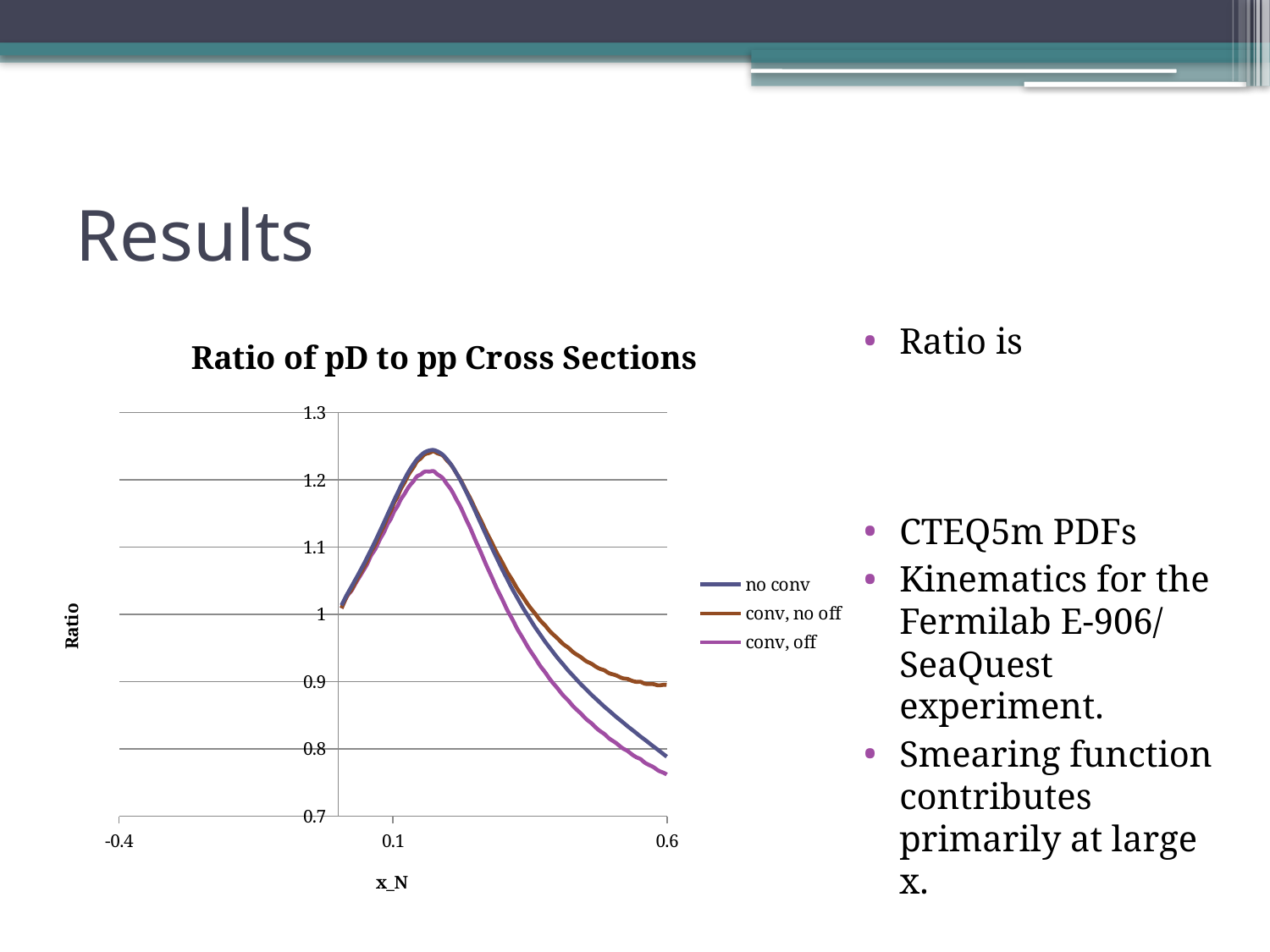
At x_N = 0.6, which series has the lowest value? conv, off Is the peak value of the 'conv, no off' series greater or less than 1.2? greater Do the values of all three series rise or fall between the left end of the lines and their peak near x_N = 0.1? rise What kind of chart is shown on the slide? line chart At x_N = 0.6, is the value of 'conv, no off' larger or smaller than the value of 'conv, off'? larger How many series does the legend of the chart list? 3 What is the title of the chart? Ratio of pD to pp Cross Sections At x_N = 0.6, which series has the highest value: 'no conv', 'conv, no off' or 'conv, off'? conv, no off Is the peak value of the 'no conv' series greater or less than 1.2? greater What is the label of the vertical axis of the chart? Ratio Is the value of 'conv, off' at x_N = 0.6 greater or less than 0.8? less Do the values of the 'no conv' series rise or fall from their peak toward x_N = 0.6? fall